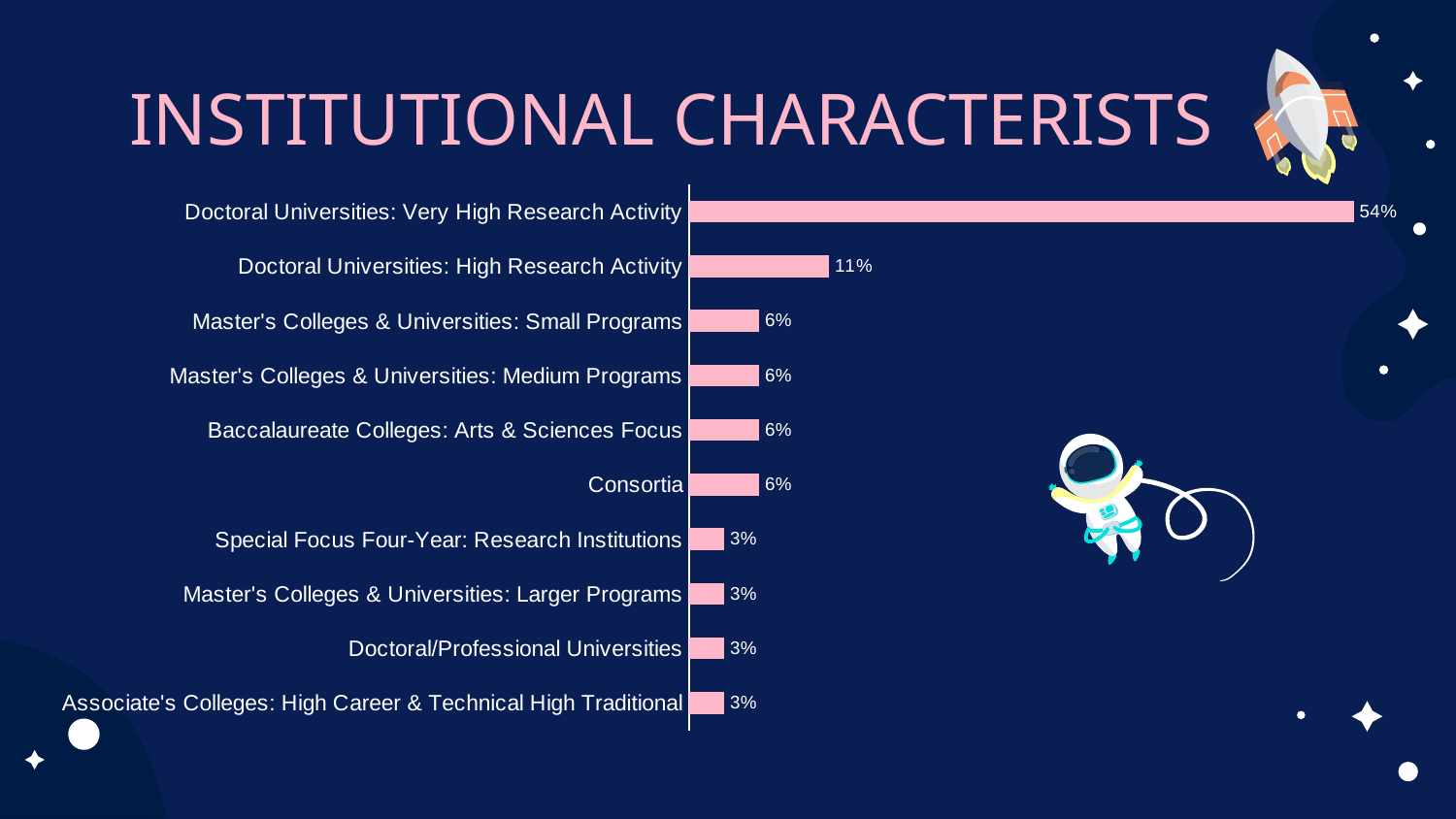
What is the title of the slide containing the chart? INSTITUTIONAL CHARACTERISTS Which category has the highest value? Doctoral Universities: Very High Research Activity What kind of chart is shown on the slide? Bar chart How many categories have a value of 3%? 4 What is the value for Consortia? 6% What is the difference between the values for Doctoral Universities: Very High Research Activity and Doctoral Universities: High Research Activity? 43% How many categories are shown in the chart? 10 What is the value for Doctoral/Professional Universities? 3% What is the value for Doctoral Universities: Very High Research Activity? 54% What is the value for Doctoral Universities: High Research Activity? 11% Which is larger, the value for Master's Colleges & Universities: Small Programs or the value for Master's Colleges & Universities: Larger Programs? Master's Colleges & Universities: Small Programs What is the difference between the values for Doctoral Universities: High Research Activity and Consortia? 5%